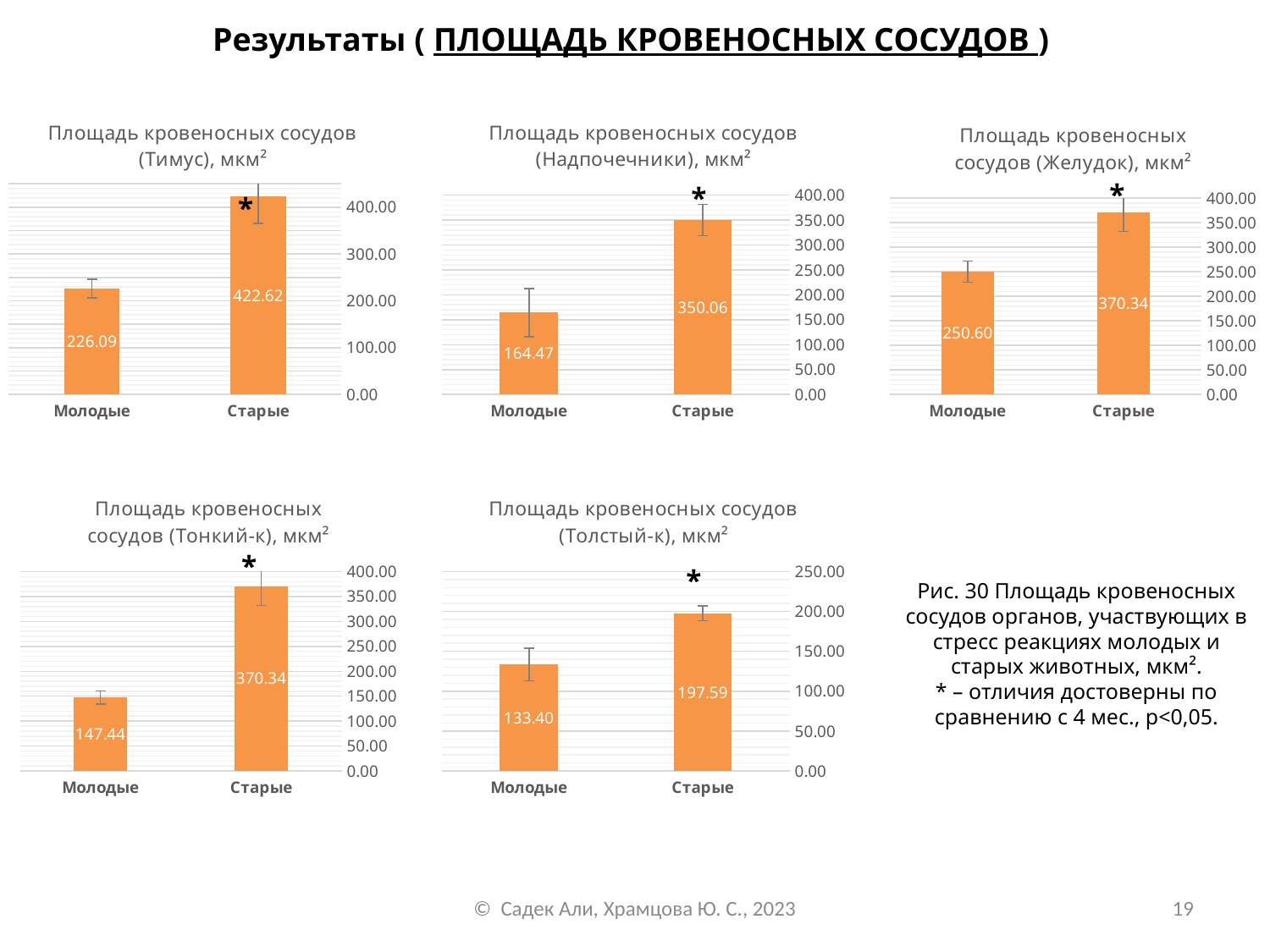
In the chart titled 'Площадь кровеносных сосудов (Тимус), мкм²', what is the difference between the values for Старые and Молодые? 196.53 In the chart titled 'Площадь кровеносных сосудов (Надпочечники), мкм²', is the value for Молодые greater or less than 200.00? less How many charts are shown on the slide? 5 What kind of chart is the chart titled 'Площадь кровеносных сосудов (Тонкий-к), мкм²'? Bar chart In the chart titled 'Площадь кровеносных сосудов (Толстый-к), мкм²', what is the value for Старые? 197.59 In the chart titled 'Площадь кровеносных сосудов (Толстый-к), мкм²', what is the difference between the values for Старые and Молодые? 64.19 In the chart titled 'Площадь кровеносных сосудов (Тимус), мкм²', which category has the lowest value? Молодые In the chart titled 'Площадь кровеносных сосудов (Тонкий-к), мкм²', which category has the higher value? Старые In the chart titled 'Площадь кровеносных сосудов (Надпочечники), мкм²', what is the value for Молодые? 164.47 In the chart titled 'Площадь кровеносных сосудов (Желудок), мкм²', what is the value for Молодые? 250.60 In the chart titled 'Площадь кровеносных сосудов (Тимус), мкм²', what is the value for Старые? 422.62 How many categories are shown on the x axis of the chart titled 'Площадь кровеносных сосудов (Желудок), мкм²'? 2